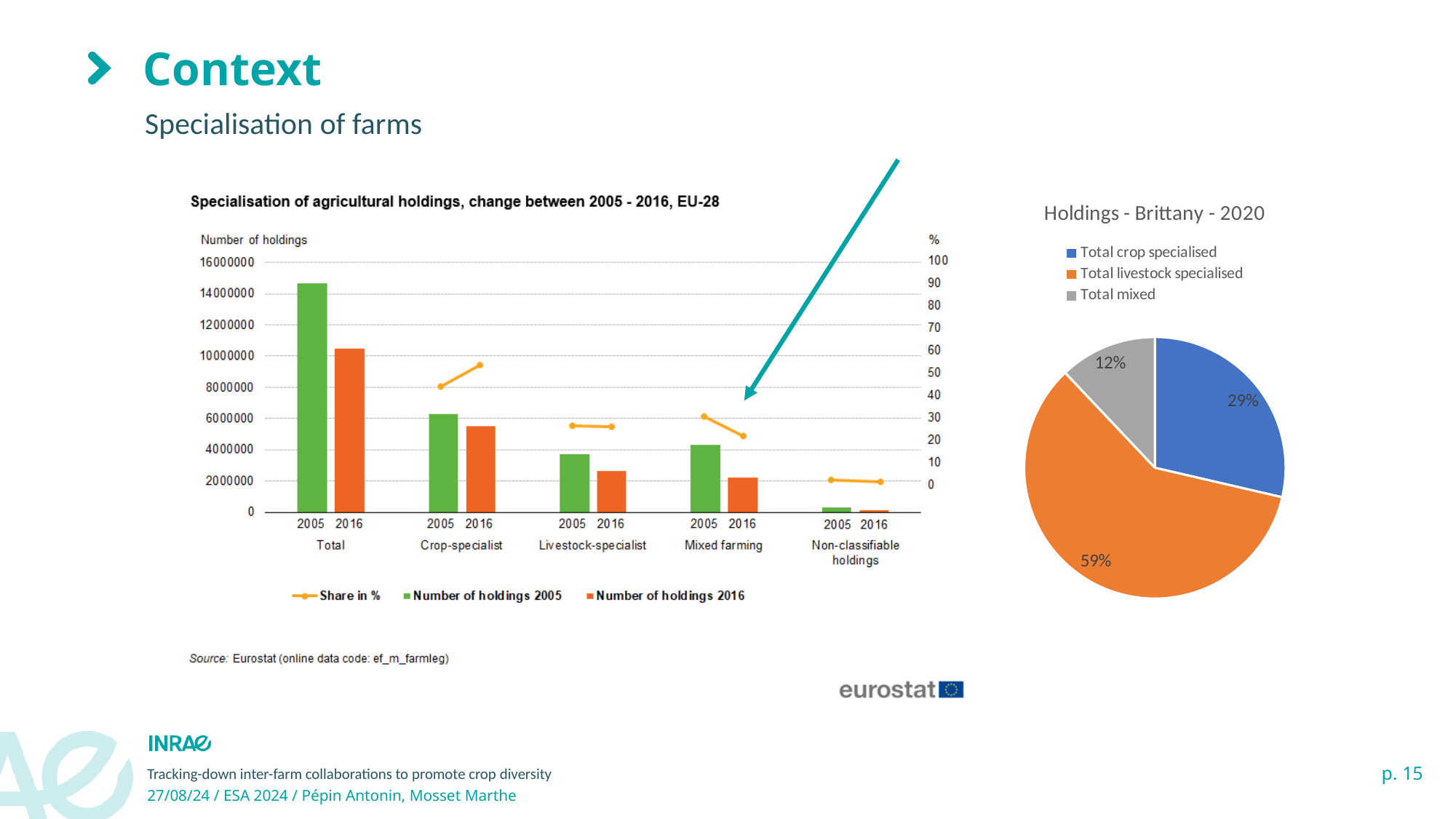
In the pie chart 'Holdings - Brittany - 2020', which category has the largest slice? Total livestock specialised In the pie chart 'Holdings - Brittany - 2020', which category has the smallest slice? Total mixed In the left bar chart, how many farm categories are shown along the x axis? 5 In the left bar chart, which is larger: the number of holdings in 2005 for Crop-specialist or for Livestock-specialist? Crop-specialist How many categories does the legend of the pie chart 'Holdings - Brittany - 2020' list? 3 In the pie chart 'Holdings - Brittany - 2020', what share is labelled for Total crop specialised? 29% In the pie chart 'Holdings - Brittany - 2020', what share is labelled for Total mixed? 12% In the left bar chart, which bar is the highest? Total 2005 What kind of chart is the 'Specialisation of agricultural holdings, change between 2005 - 2016, EU-28' chart on the left? bar chart In the left bar chart, is the number of holdings for Total in 2005 greater or less than 14000000? greater In the pie chart 'Holdings - Brittany - 2020', what share is labelled for Total livestock specialised? 59% In the pie chart 'Holdings - Brittany - 2020', what is the difference in percentage points between Total livestock specialised and Total crop specialised? 30